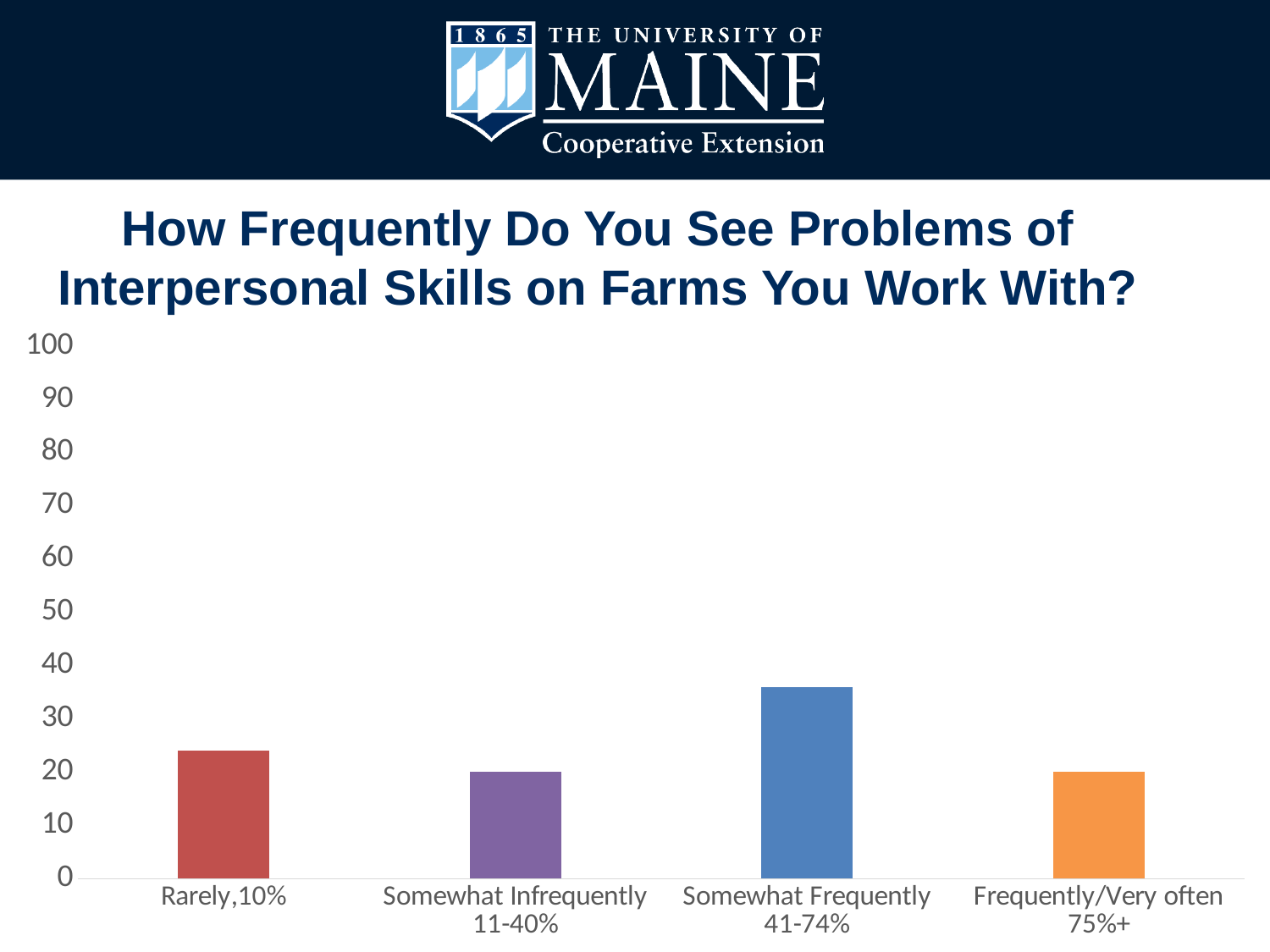
Is the value for Somewhat Infrequently 11-40% greater or less than 30? less How many categories are shown on the x axis of the chart? 4 Is the value for Frequently/Very often 75%+ greater or less than 30? less Is the value for Rarely,10% greater or less than 30? less What kind of chart is shown on the slide? bar chart Which category has the highest bar? Somewhat Frequently 41-74% Which is larger, the value for Rarely,10% or the value for Somewhat Infrequently 11-40%? Rarely,10% What is the title of the chart? How Frequently Do You See Problems of Interpersonal Skills on Farms You Work With? What colour is the bar for Frequently/Very often 75%+? orange